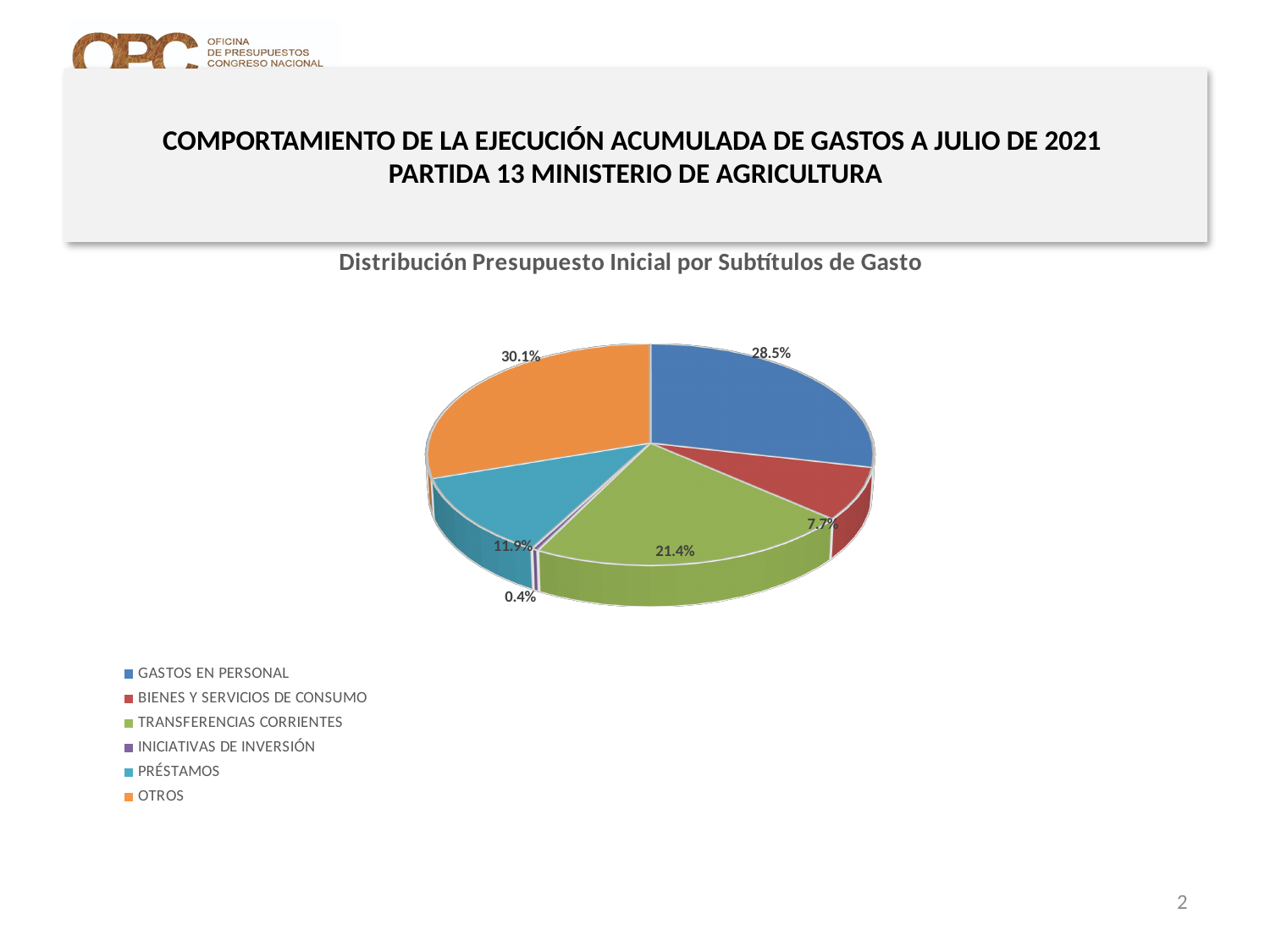
What share of the pie does GASTOS EN PERSONAL represent? 28.5% What is the title of the chart? Distribución Presupuesto Inicial por Subtítulos de Gasto What share of the pie does INICIATIVAS DE INVERSIÓN represent? 0.4% Which category has the largest share of the pie? OTROS What is the difference in percentage points between OTROS and GASTOS EN PERSONAL? 1.6 How many categories does the legend list? 6 What share of the pie does PRÉSTAMOS represent? 11.9% What kind of chart is shown on the slide? Pie chart Which category has the smallest share of the pie? INICIATIVAS DE INVERSIÓN